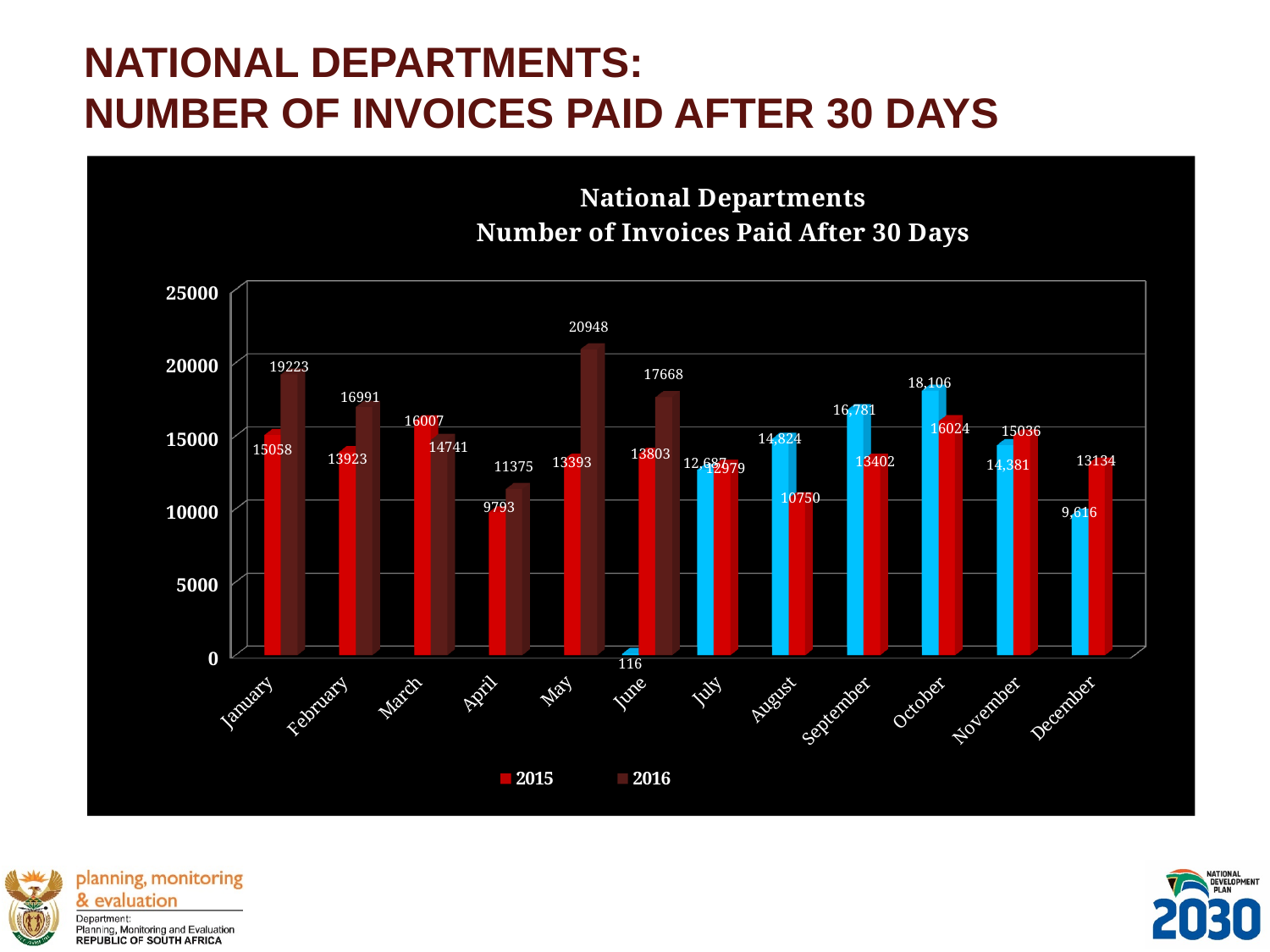
How many series does the legend list? 2 What is the difference between the 2016 and 2015 values for May? 7555 What kind of chart is shown? bar chart Which month has the highest 2016 value? May What is the 2015 value for January? 15058 For March, which is larger, the 2015 value or the 2016 value? 2015 Which month has the lowest 2015 value? April How many months are shown on the x axis? 12 What is the difference between the 2016 and 2015 values for January? 4165 What is the 2015 value for August? 10750 Is the 2016 value for April greater or less than 10000? greater What is the 2016 value for May? 20948